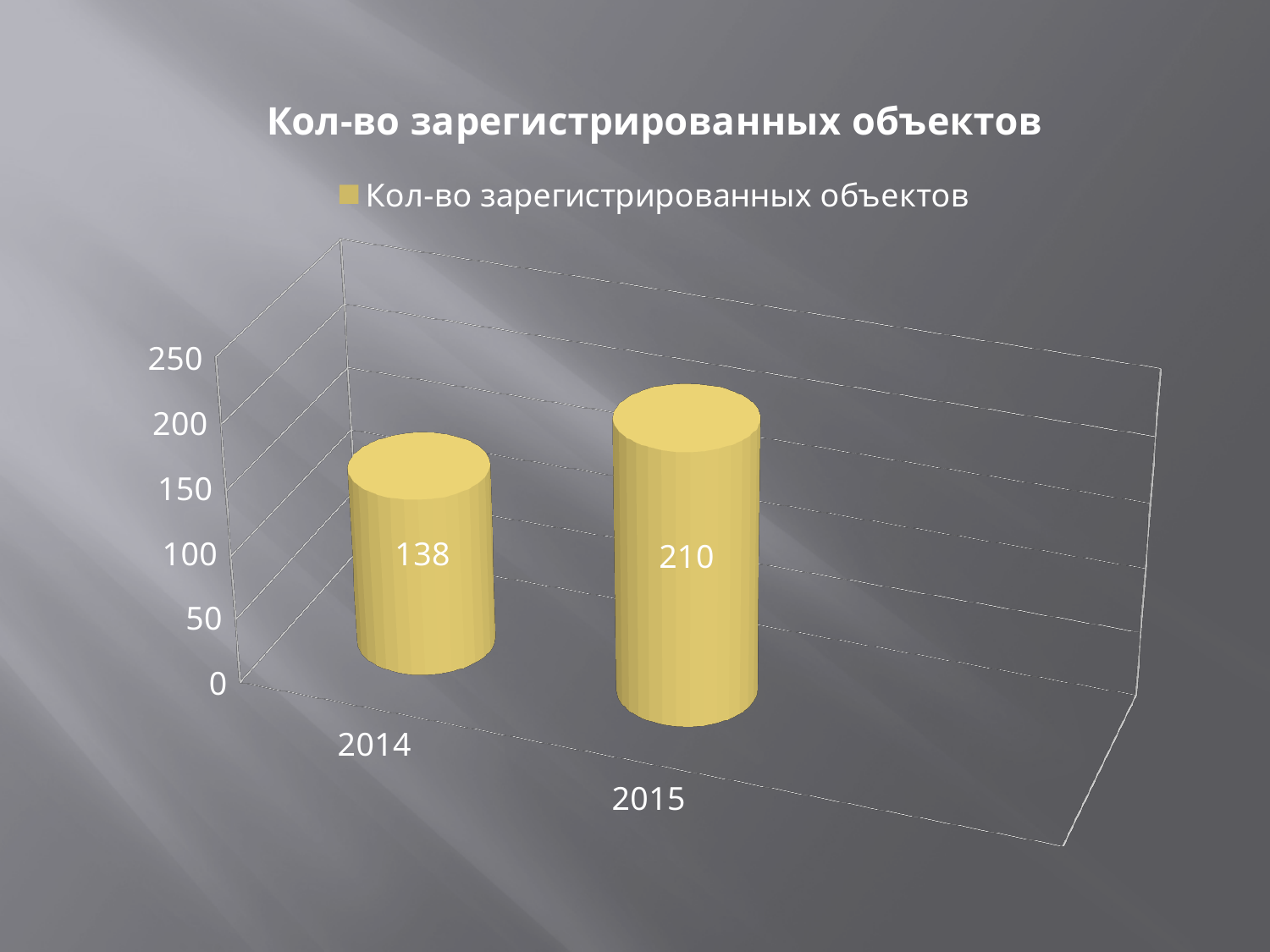
What kind of chart is shown on the slide? bar chart Which year has the highest number of registered objects? 2015 Is the value for 2014 greater or less than 150? less Is the value for 2015 greater or less than 200? greater What is the title of the chart? Кол-во зарегистрированных объектов What is the value for 2015? 210 How many categories are shown on the x axis? 2 How many series does the legend list? 1 Which year has the lowest number of registered objects? 2014 Which is larger, the value for 2014 or the value for 2015? 2015 What is the difference between the values for 2015 and 2014? 72 What is the value for 2014? 138